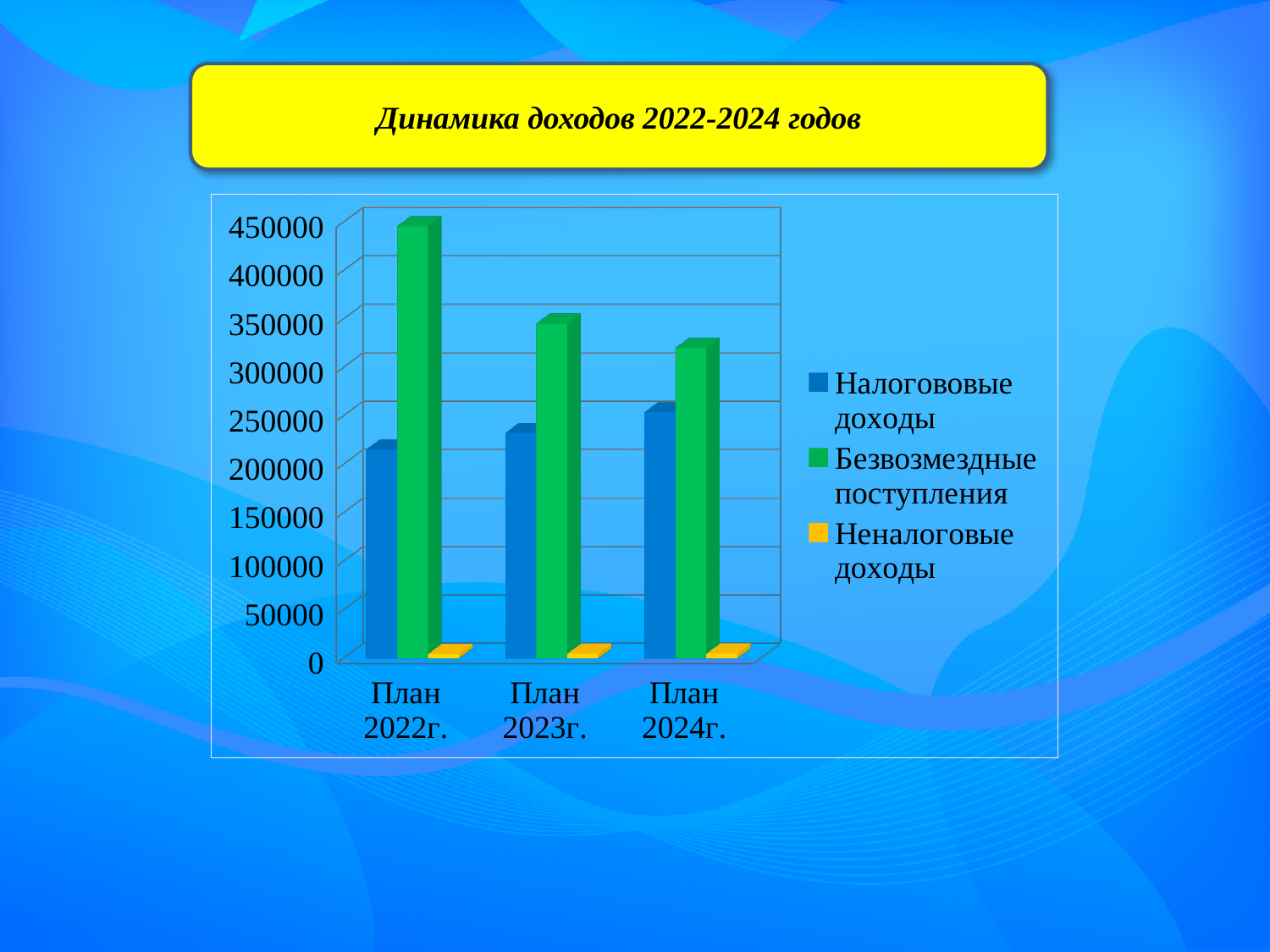
Which series has the tallest bar in the chart? Безвозмездные поступления Is the value for Безвозмездные поступления in План 2022г. greater or less than 400000? greater How many series does the legend list? 3 Which series is shown in green in the chart? Безвозмездные поступления Is the value for Налоговые доходы in План 2024г. greater or less than 300000? less Which series has the lowest bar in every year? Неналоговые доходы Which is larger: Безвозмездные поступления for План 2022г. or for План 2023г.? План 2022г. Do the values for Безвозмездные поступления rise or fall from План 2022г. to План 2024г.? Fall What kind of chart is shown on the slide? Bar chart How many categories are shown on the x axis of the chart? 3 What is the title of the slide above the chart? Динамика доходов 2022-2024 годов Do the values for Налоговые доходы rise or fall from План 2022г. to План 2024г.? Rise